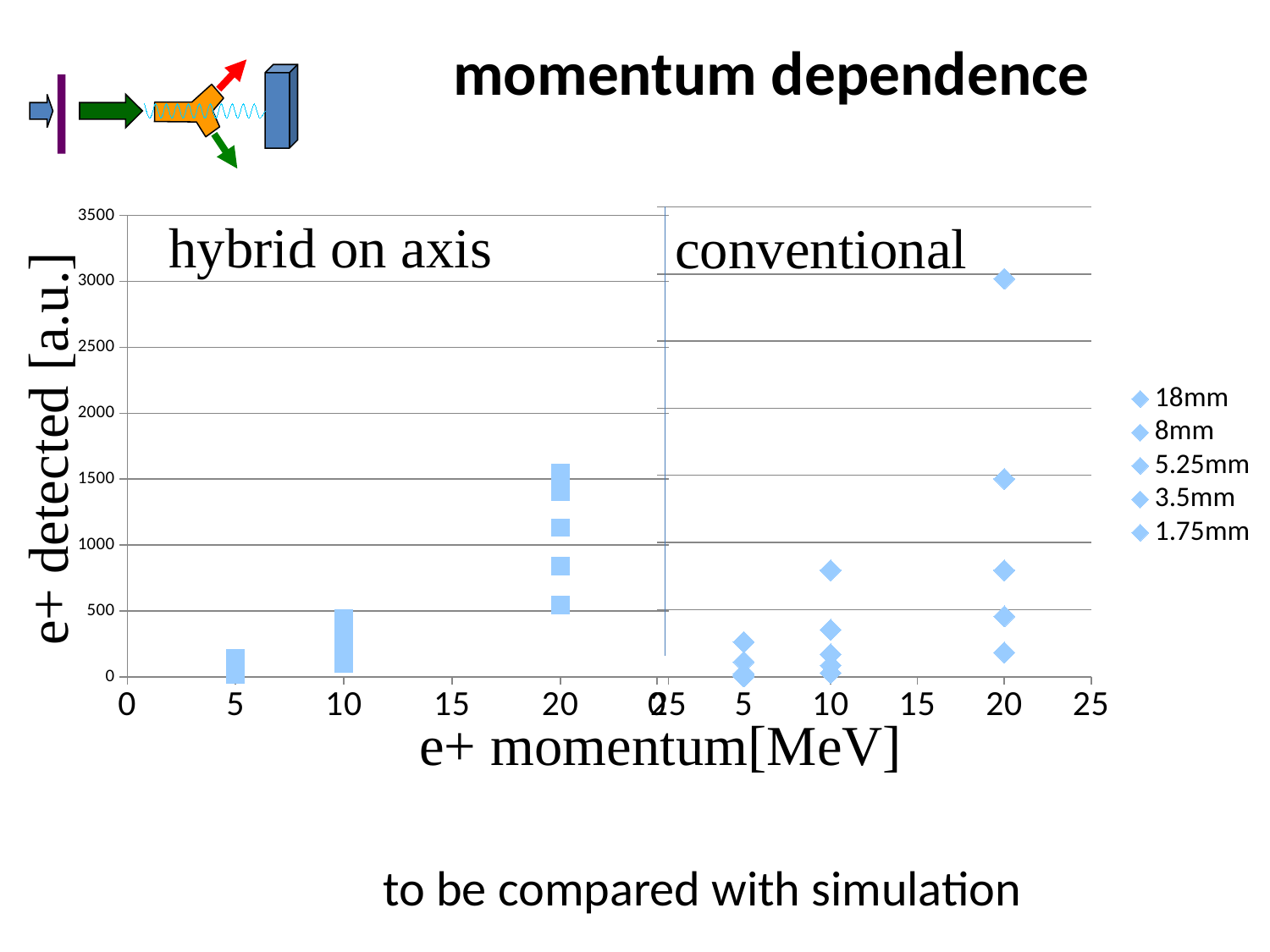
What is the label of the x axis? e+ momentum[MeV] In the 'conventional' chart, are all the points at 5 MeV greater or less than 500? less How many series does the legend list? 5 In the 'hybrid on axis' chart, is the highest point at 20 MeV greater or less than 1000? greater In the 'conventional' chart, at how many distinct momentum values are points plotted? 3 Which chart has the larger maximum value at 20 MeV, 'hybrid on axis' or 'conventional'? conventional In the 'conventional' chart, is the highest point at 20 MeV greater or less than 2500? greater In the 'hybrid on axis' chart, do the detected values rise or fall as the e+ momentum increases? rise In the 'hybrid on axis' chart, at how many distinct momentum values are points plotted? 3 What kind of chart is shown on the slide? scatter chart